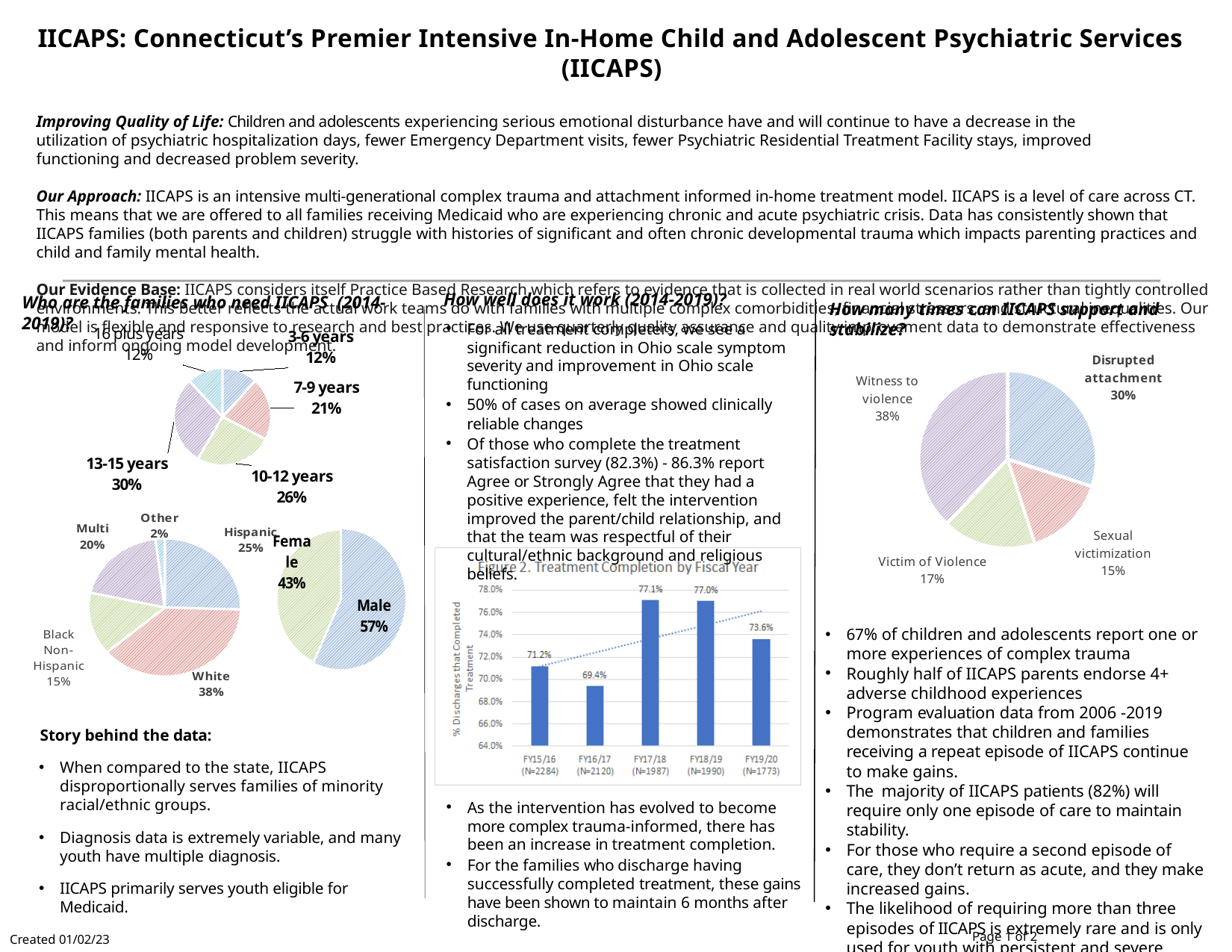
In the race/ethnicity pie chart at the bottom left, which category has the smallest share? Other In the gender pie chart at the bottom left, which is larger, Male or Female? Male In the chart titled 'Figure 2. Treatment Completion by Fiscal Year', what is the value for FY17/18? 77.1% How many age groups are shown in the age pie chart at the top left? 5 In the chart titled 'Figure 2. Treatment Completion by Fiscal Year', which fiscal year has the lowest completion rate? FY16/17 In the age pie chart at the top left, what share of families is in the 13-15 years group? 30% In the trauma pie chart on the right, what share is Disrupted attachment? 30% In the age pie chart at the top left, which age group has the largest share? 13-15 years What kind of chart is 'Figure 2. Treatment Completion by Fiscal Year'? Bar chart In the race/ethnicity pie chart at the bottom left, what share is White? 38% In the trauma pie chart on the right, which category has the largest share? Witness to violence In the race/ethnicity pie chart at the bottom left, what is the difference between the Hispanic and Black Non-Hispanic shares? 10%